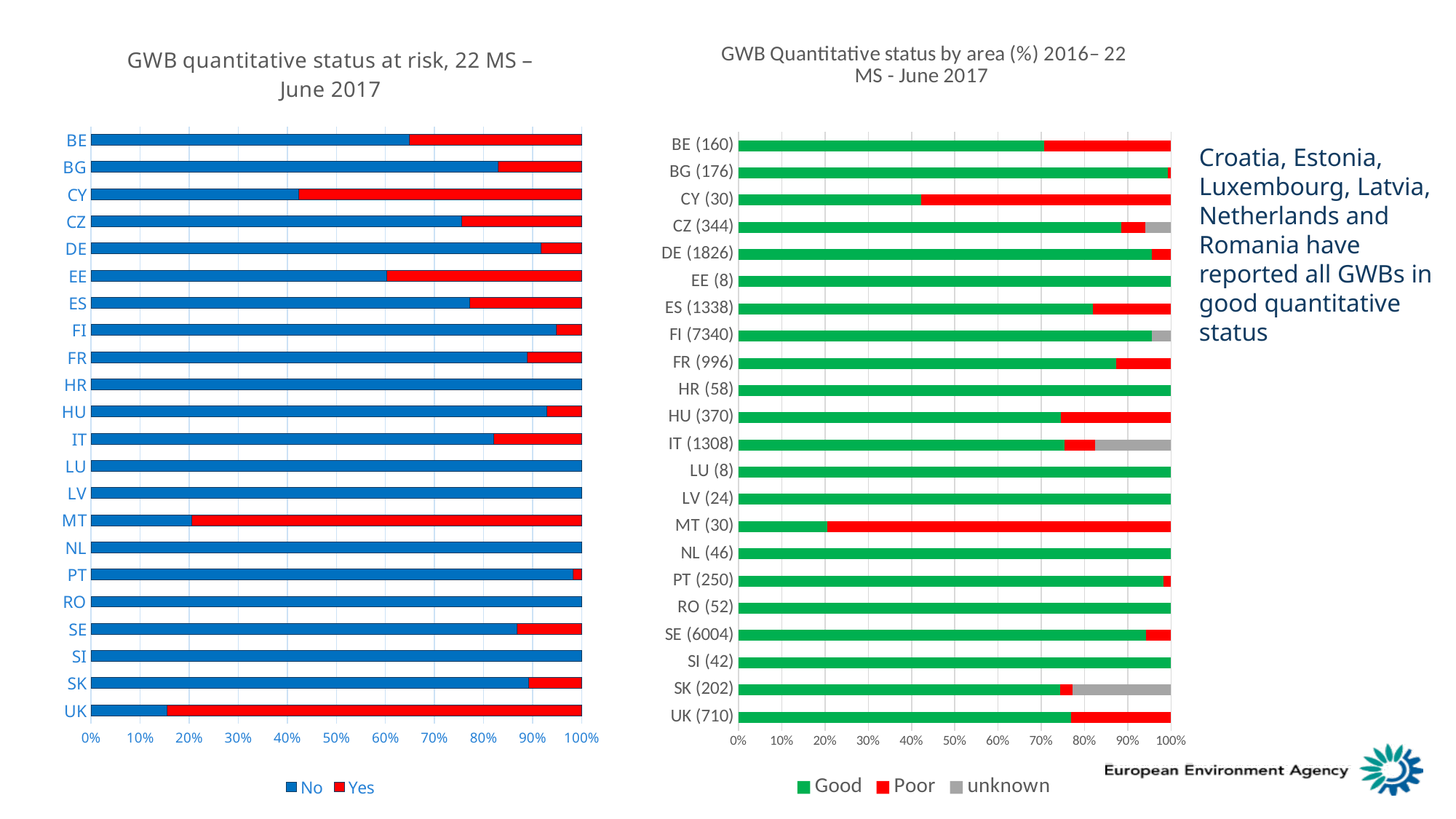
How many series does the legend of the left chart, 'GWB quantitative status at risk', list? 2 In the left chart, 'GWB quantitative status at risk', which member state has the lowest 'No' share? UK In the right chart, 'GWB Quantitative status by area (%)', which member state has the lowest 'Good' share? MT (30) How many series does the legend of the right chart, 'GWB Quantitative status by area (%)', list? 3 In the right chart, 'GWB Quantitative status by area (%)', is the 'Good' share for CY (30) greater or less than 50%? less In the left chart, 'GWB quantitative status at risk', is the 'No' share for MT greater or less than 30%? less In the left chart, 'GWB quantitative status at risk', is the 'No' share for BE greater or less than 60%? greater What kind of chart is the left chart, 'GWB quantitative status at risk, 22 MS – June 2017'? Stacked bar chart How many member states (categories) are shown in the left chart, 'GWB quantitative status at risk'? 22 In the right chart, 'GWB Quantitative status by area (%)', what colour represents the 'Poor' series? Red